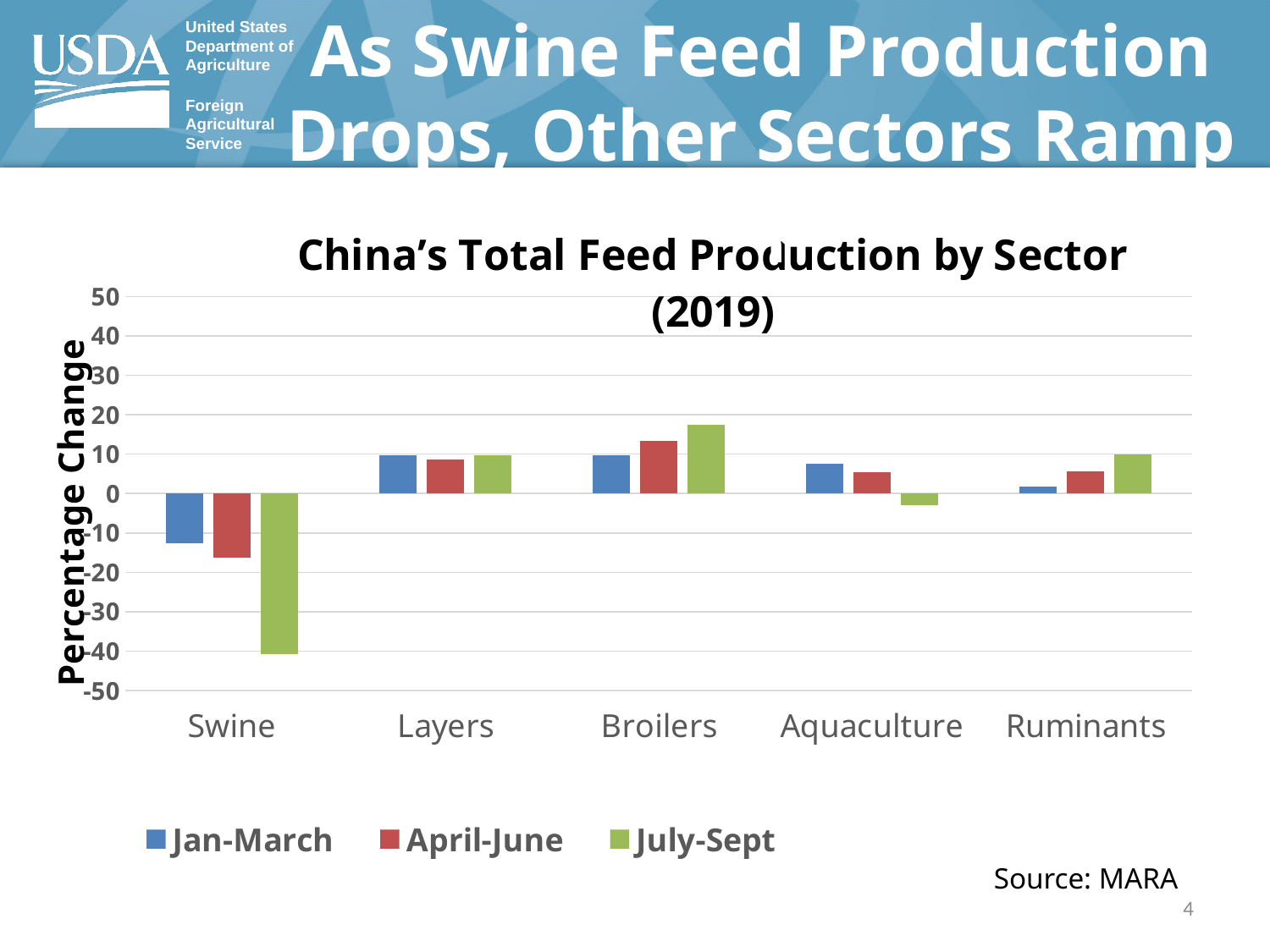
Is the April-June value for Swine greater or less than -10? less How many series does the chart's legend list? 3 What is the label on the vertical axis of the chart? Percentage Change How many sectors are shown on the x axis of the chart? 5 Is the July-Sept value for Aquaculture greater or less than 0? less Is the July-Sept value for Broilers greater or less than 10? greater Which is larger for Swine: the Jan-March value or the July-Sept value? Jan-March Which sector has the highest July-Sept value? Broilers Which sector has the lowest July-Sept value? Swine Do the values for Swine rise or fall from Jan-March to July-Sept? Fall What kind of chart is shown on the slide? Bar chart